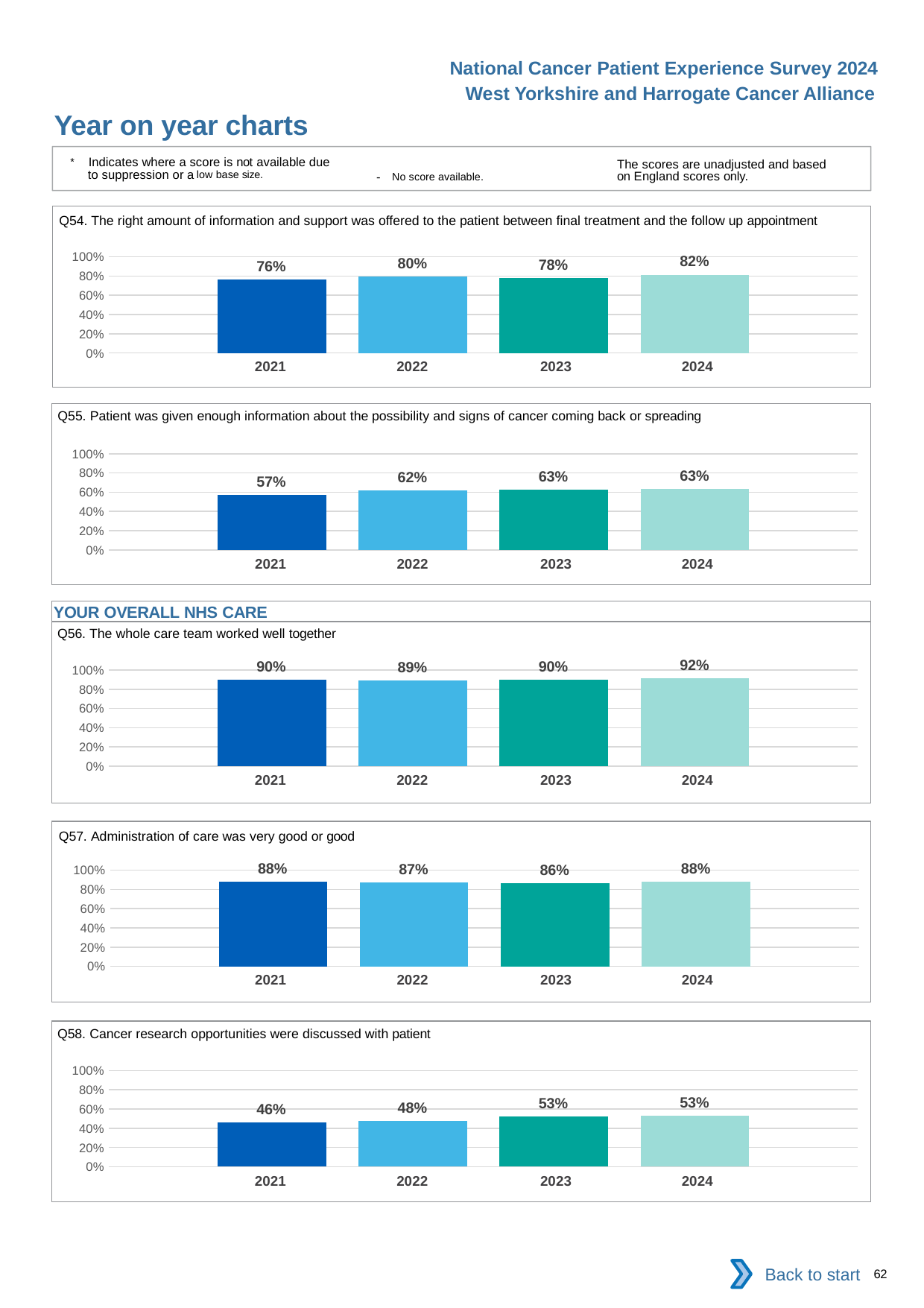
In the Q55 chart, what is the difference between the 2022 value and the 2021 value? 5% In the Q58 chart, how many years are plotted? 4 In the Q57 chart, which is larger, the value for 2021 or the value for 2023? 2021 What is the section heading shown above the Q56 chart? YOUR OVERALL NHS CARE In the Q56 chart, what is the value for 2023? 90% In the Q58 chart, what is the value for 2021? 46% In the Q54 chart, which year has the highest value? 2024 In the Q54 chart, what is the value for 2024? 82% In the Q56 chart, what is the difference between the 2024 value and the 2022 value? 3% In the Q58 chart, do the values generally rise or fall from 2021 to 2024? Rise In the Q55 chart, which year has the lowest value? 2021 What kind of chart is the Q54 chart? Bar chart